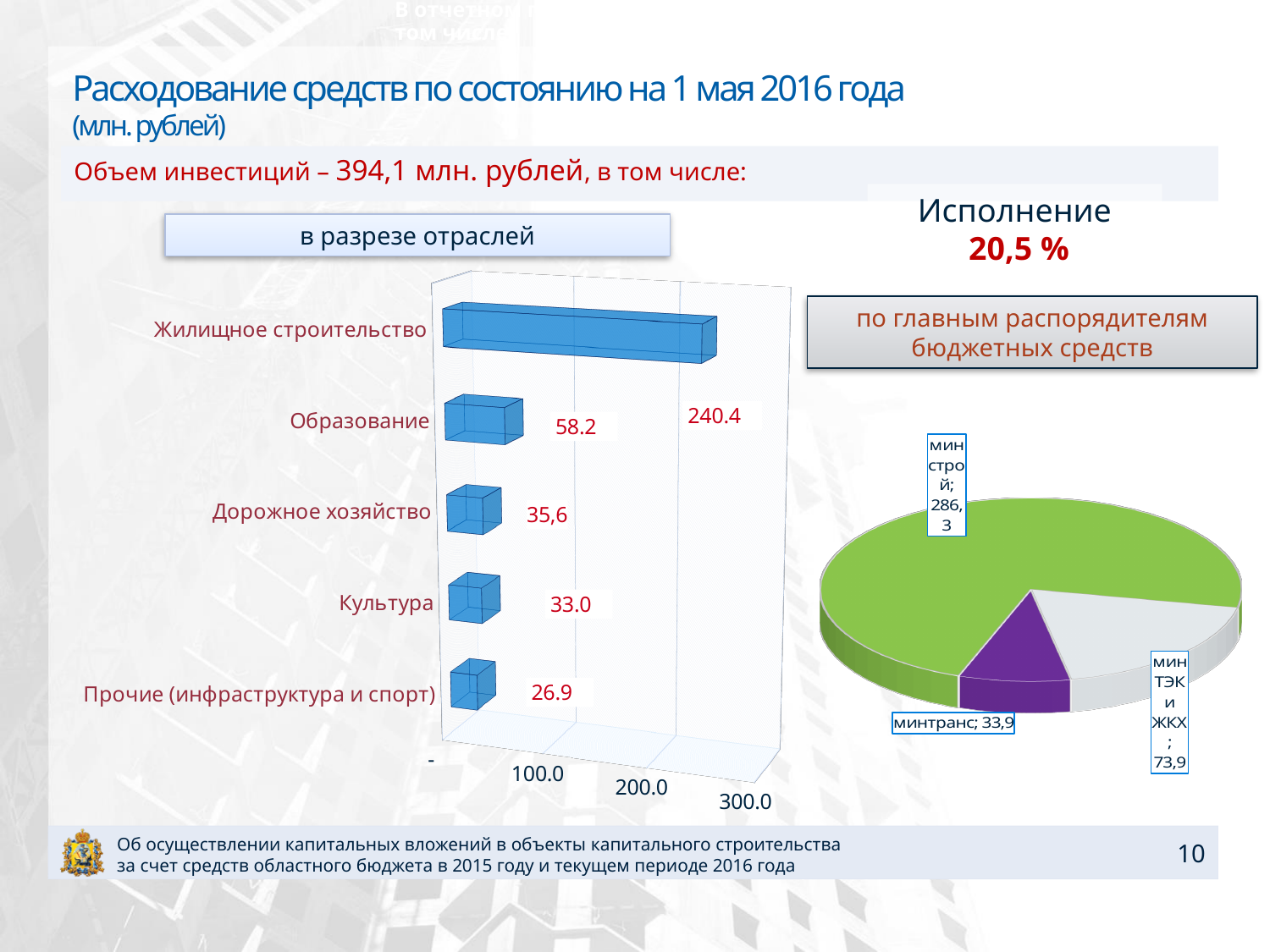
On the bar chart 'в разрезе отраслей', what is the value for Дорожное хозяйство? 35,6 On the bar chart 'в разрезе отраслей', what is the value for Жилищное строительство? 240.4 On the bar chart 'в разрезе отраслей', which category has the lowest value? Прочие (инфраструктура и спорт) On the bar chart 'в разрезе отраслей', which category has the highest value? Жилищное строительство On the bar chart 'в разрезе отраслей', is the value for Жилищное строительство greater or less than 200.0? greater On the pie chart 'по главным распорядителям бюджетных средств', what is the value for минстрой? 286,3 On the bar chart 'в разрезе отраслей', what is the difference between Жилищное строительство and Образование? 182.2 On the pie chart 'по главным распорядителям бюджетных средств', which is larger: минтранс or минТЭК и ЖКХ? минТЭК и ЖКХ On the bar chart 'в разрезе отраслей', how many categories are shown? 5 On the pie chart 'по главным распорядителям бюджетных средств', how many slices are there? 3 On the bar chart 'в разрезе отраслей', what is the value for Прочие (инфраструктура и спорт)? 26.9 What kind of chart is the chart on the left, 'в разрезе отраслей'? bar chart